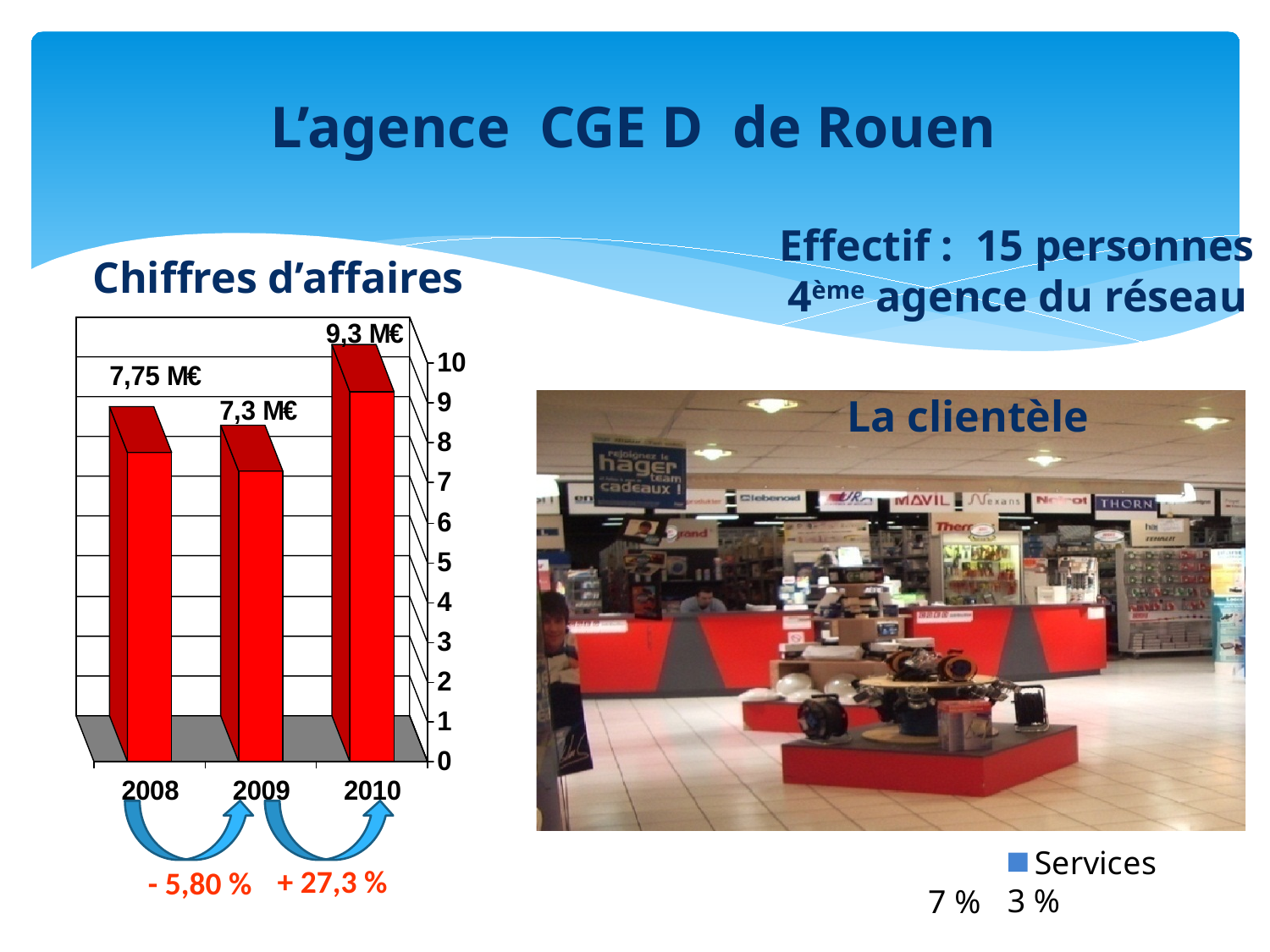
In the 'Chiffres d'affaires' chart, what is the value for 2010? 9,3 M€ In the 'Chiffres d'affaires' chart, what is the difference between the 2008 and 2009 values? 0,45 M€ What kind of chart is the 'Chiffres d'affaires' chart? Bar chart In the 'Chiffres d'affaires' chart, which year has the lowest value? 2009 In the 'Chiffres d'affaires' chart, which is larger, the value for 2008 or the value for 2010? 2010 How many years are shown in the 'Chiffres d'affaires' chart? 3 In the 'Chiffres d'affaires' chart, which year has the highest value? 2010 What colour are the bars in the 'Chiffres d'affaires' chart? Red In the 'Chiffres d'affaires' chart, what is the value for 2009? 7,3 M€ In the 'Chiffres d'affaires' chart, is the value for 2010 greater or less than 9? greater In the 'Chiffres d'affaires' chart, what is the value for 2008? 7,75 M€ In the 'Chiffres d'affaires' chart, what is the difference between the 2010 and 2009 values? 2 M€